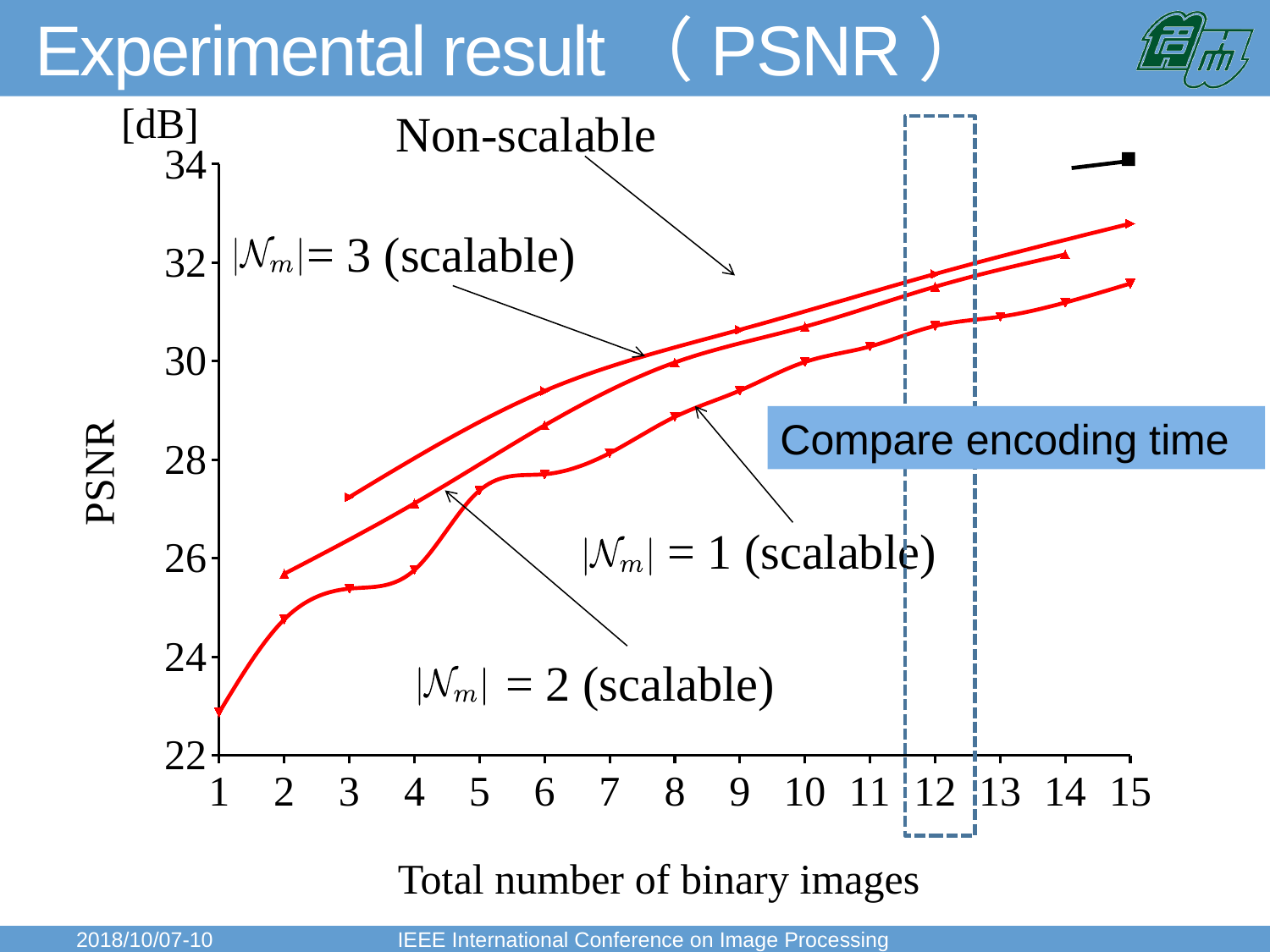
At 15 binary images, which has the higher PSNR: the top red curve or the lowest red curve? the top red curve Which curve has the lowest PSNR at 10 binary images: the top red curve or the lowest red curve? the lowest red curve How many tick values are shown on the x-axis? 15 What is the label of the x-axis? Total number of binary images Do the PSNR values of the red curves rise or fall as the total number of binary images increases? rise What type of chart is shown on the slide? line chart Is the PSNR of the top red curve at 3 binary images greater or less than 28? less Is the PSNR of the lowest red curve at 15 binary images greater or less than 32? less Is the PSNR of the lowest red curve at 1 binary image greater or less than 24? less What is the unit shown for the y-axis? [dB] What is the label of the y-axis? PSNR